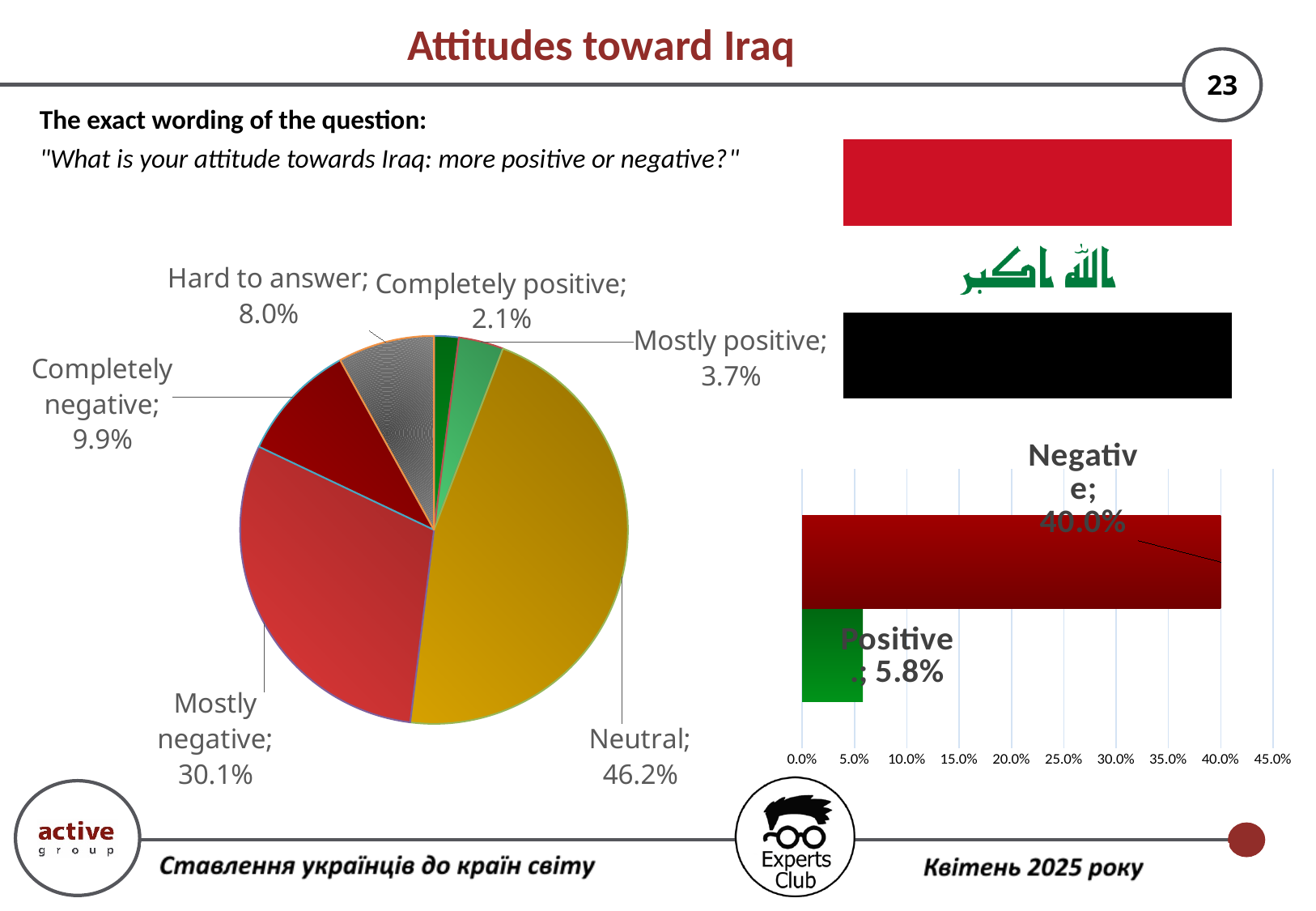
In the pie chart on the left, which category has the largest share? Neutral In the pie chart on the left, which is larger: "Completely negative" or "Hard to answer"? Completely negative How many categories does the pie chart on the left show? 6 In the pie chart on the left, what share of respondents answered "Neutral"? 46.2% In the bar chart on the right, what is the value for "Negative"? 40.0% In the bar chart on the right, what is the value for "Positive"? 5.8% In the bar chart on the right, what is the difference between "Negative" and "Positive"? 34.2% In the pie chart on the left, what is the value for "Hard to answer"? 8.0% What kind of chart is shown on the right side of the slide? Bar chart In the pie chart on the left, what is the difference between "Mostly negative" and "Completely negative"? 20.2% In the pie chart on the left, what is the value for "Mostly negative"? 30.1% In the pie chart on the left, which category has the smallest share? Completely positive